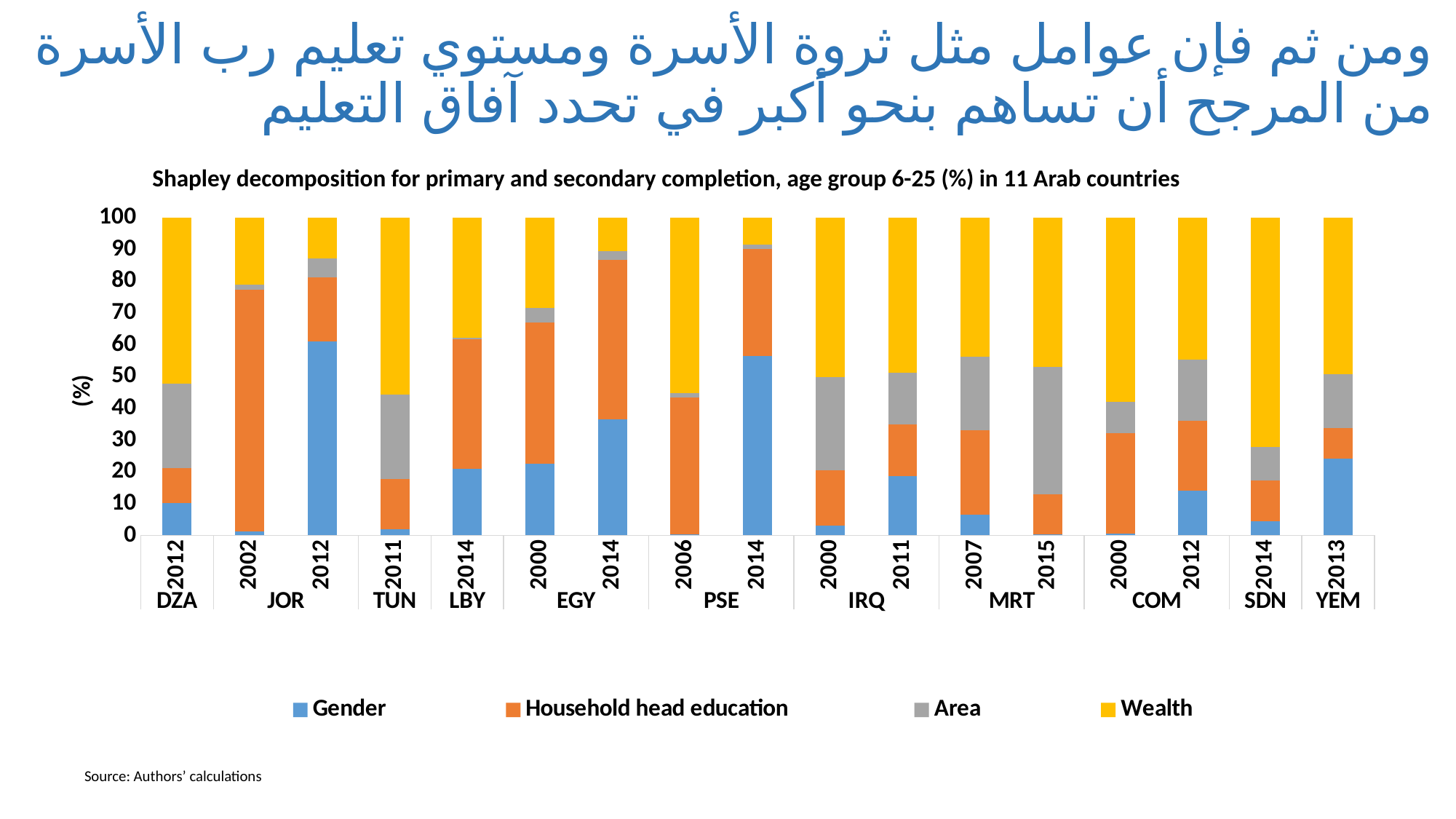
Which colour represents Wealth in the legend? Yellow What kind of chart is shown on the slide? Stacked bar chart Which bar has the largest Household head education segment? JOR 2002 Is the Gender value for EGY 2014 greater or less than 30? greater Is the Gender value for JOR 2012 greater or less than 50? greater How many series does the legend list? 4 How many bars are plotted in the chart? 17 Is the Gender segment larger for EGY 2000 or EGY 2014? EGY 2014 Is the Gender value for SDN 2014 greater or less than 10? less What is the total of the stacked bar for DZA 2012? 100 Which bar has the largest Area segment? MRT 2015 Which bar has the largest Wealth segment? SDN 2014